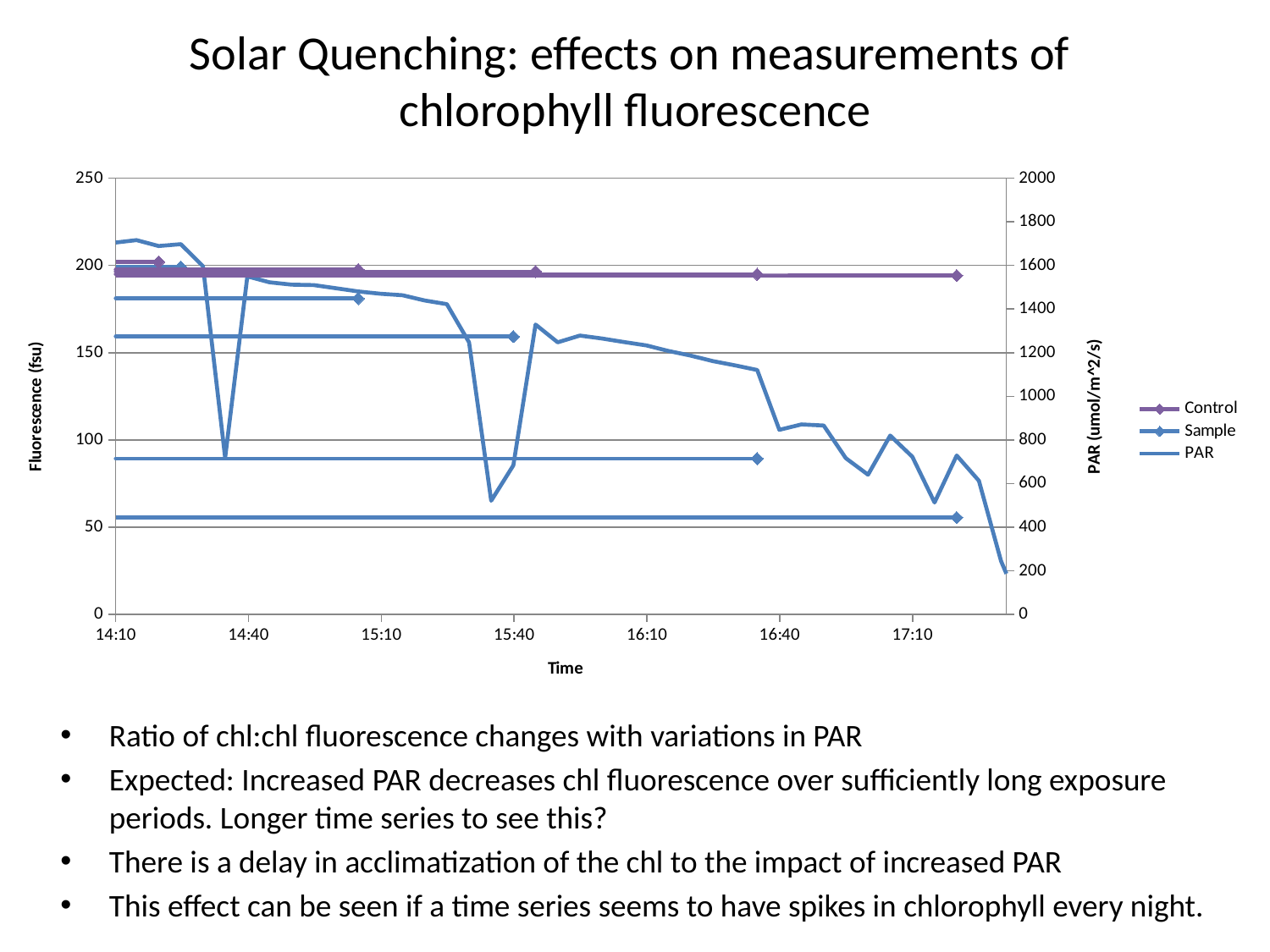
Is the PAR value at the final point of the series (after 17:10) greater or less than 400 umol/m^2/s? less At around 17:20, which series has the higher fluorescence value, Control or Sample? Control What are the three series named in the chart legend? Control, Sample, PAR Does the Sample series rise or fall overall from 14:10 to the end of the time series? fall What is the title of the left vertical axis of the chart? Fluorescence (fsu) Does the PAR series rise or fall overall across the time axis? fall Is the Sample fluorescence value at its last marker (around 17:20) greater or less than 100? less Is the Control fluorescence value at its last marker (around 17:20) greater or less than 150? greater What kind of chart is shown on the slide? line chart How many series does the chart legend list? 3